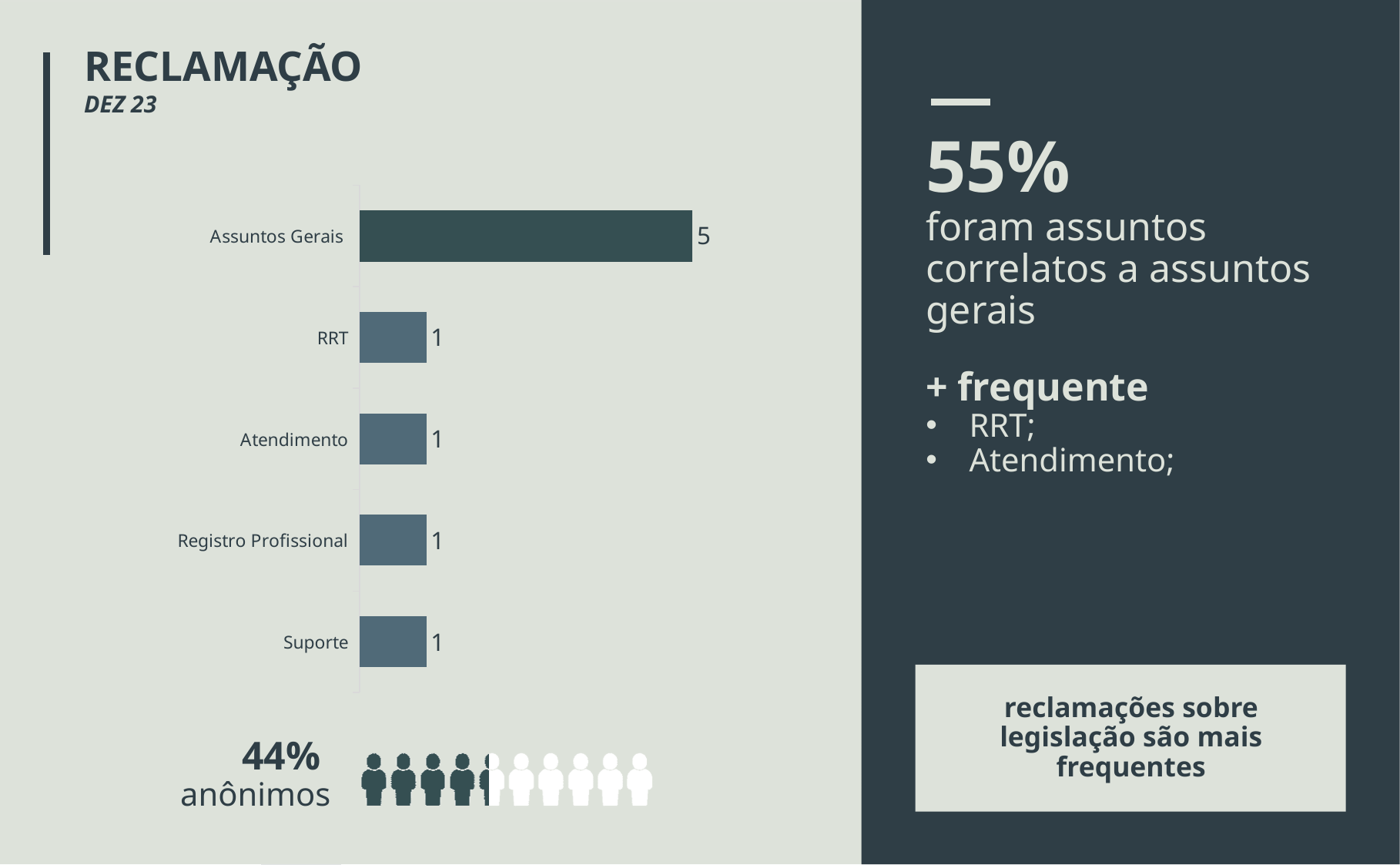
What is the value for Assuntos Gerais? 5 What is the total of all the values shown in the bar chart? 9 Which is larger, the value for Assuntos Gerais or the value for RRT? Assuntos Gerais What is the value for RRT? 1 What is the value for Registro Profissional? 1 Which category is listed at the top of the bar chart? Assuntos Gerais Which category has the highest value? Assuntos Gerais What is the value for Suporte? 1 How many categories are shown in the bar chart? 5 What is the difference between the values for Assuntos Gerais and Atendimento? 4 What kind of chart is shown on the slide? bar chart Which bar in the chart is a darker colour than the others? Assuntos Gerais